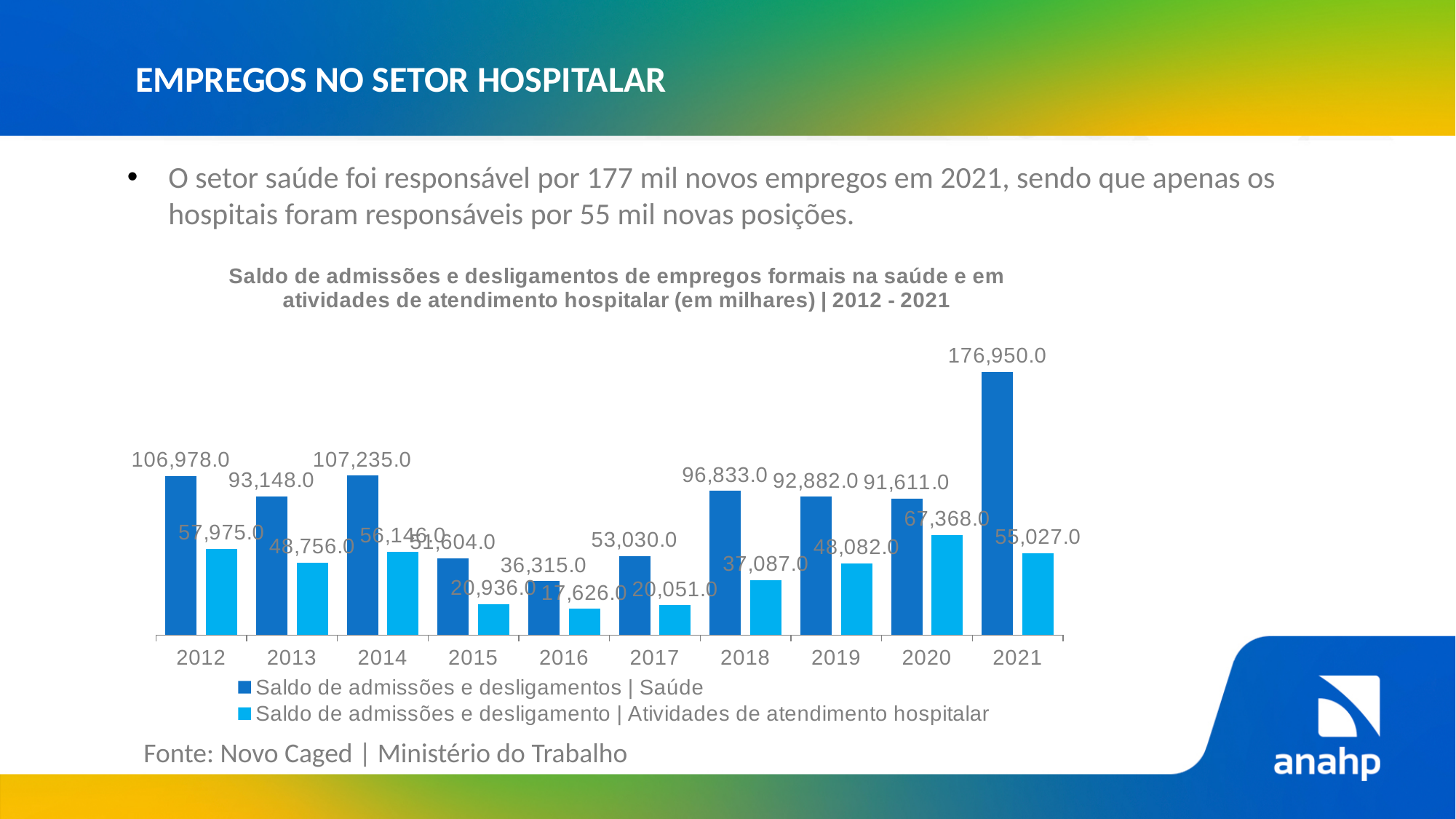
What is the value for Atividades de atendimento hospitalar in 2016? 17,626.0 Which year has the highest value for the Atividades de atendimento hospitalar series? 2020 What is the value for Saúde (Saldo de admissões e desligamentos) in 2021? 176,950.0 Which is larger for the Saúde series: the value in 2018 or the value in 2020? 2018 What is the difference between the Saúde value and the Atividades de atendimento hospitalar value in 2021? 121,923.0 What is the value for Atividades de atendimento hospitalar in 2020? 67,368.0 How many years are shown on the x axis? 10 Which year has the lowest value for the Saúde series? 2016 What is the difference between the Saúde value and the Atividades de atendimento hospitalar value in 2012? 49,003.0 Which year has the highest value for the Saúde series? 2021 Does the Atividades de atendimento hospitalar series rise or fall from 2016 to 2020? rise How many series does the legend list? 2